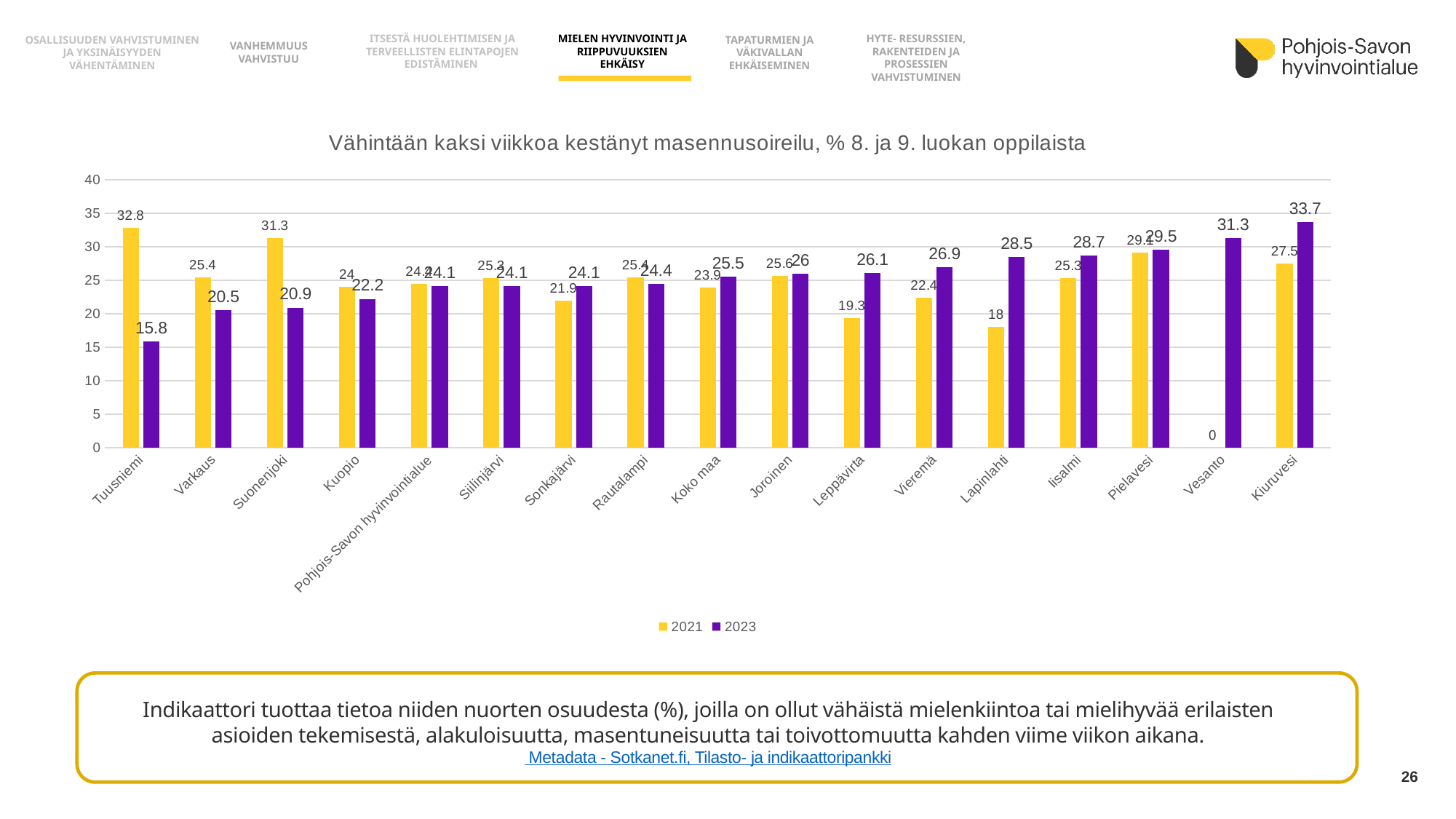
How many municipalities/areas are shown on the x axis? 17 Which category has the highest 2023 value? Kiuruvesi Which category has the highest 2021 value? Tuusniemi What is the 2023 value for Kiuruvesi? 33.7 What kind of chart is shown on the slide? bar chart Which category has the lowest 2023 value? Tuusniemi Do the 2023 values rise or fall moving from left to right along the x axis? rise What is the 2021 value for Tuusniemi? 32.8 What is the difference between the 2021 and 2023 values for Tuusniemi? 17 How many series does the legend list? 2 What is the 2021 value for Leppävirta? 19.3 For Lapinlahti, which year has the larger value, 2021 or 2023? 2023